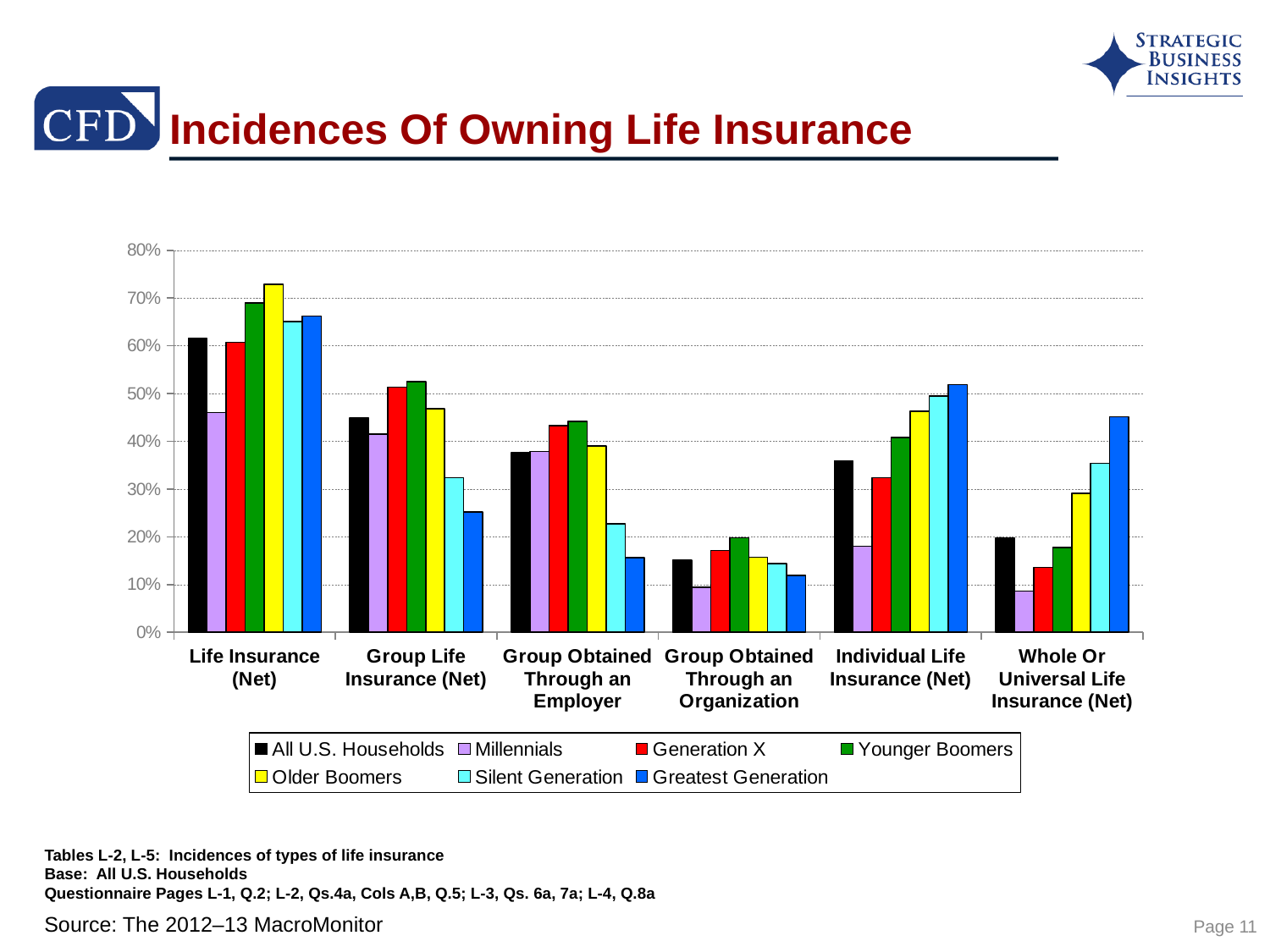
Within the Group Obtained Through an Organization category, which group has the lowest incidence? Millennials What kind of chart is shown on the slide? bar chart Within the Whole Or Universal Life Insurance (Net) category, which group has the highest incidence? Greatest Generation How many insurance categories are shown along the x axis? 6 Within the Life Insurance (Net) category, which group has the highest incidence? Older Boomers Within the Life Insurance (Net) category, which group has the lowest incidence? Millennials In Group Life Insurance (Net), which is larger: Silent Generation or Greatest Generation? Silent Generation How many series does the legend list? 7 In Individual Life Insurance (Net), which is larger: Millennials or Generation X? Generation X What is the title of the chart on the slide? Incidences Of Owning Life Insurance Is the value for Millennials in Life Insurance (Net) greater or less than 50%? less Is the value for Greatest Generation in Whole Or Universal Life Insurance (Net) greater or less than 40%? greater